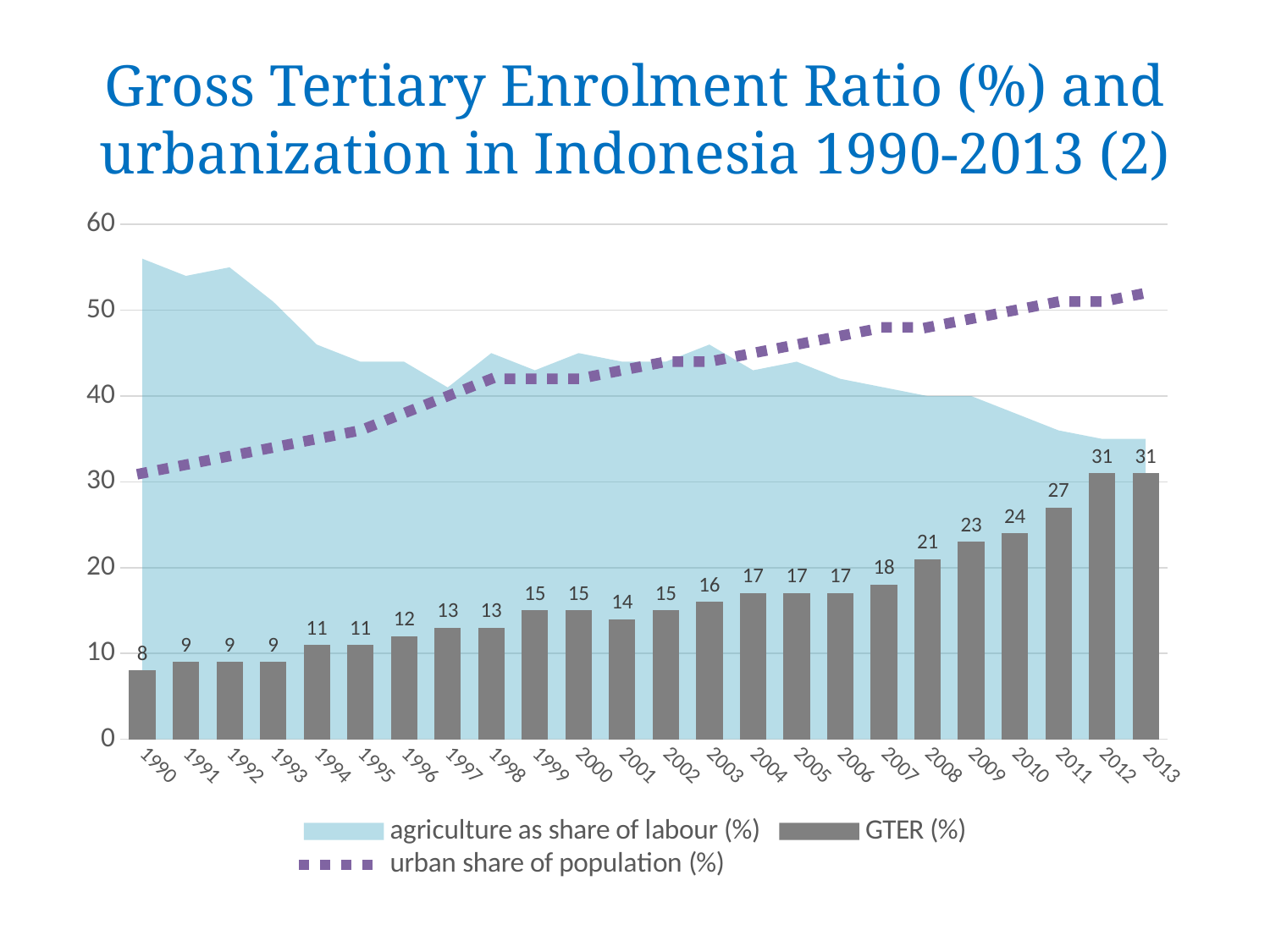
Is the urban share of population (%) value for 1990 greater or less than 40? less Is the agriculture as share of labour (%) value for 1990 greater or less than 50? greater Does the urban share of population (%) series rise or fall from 1990 to 2013? rise How many years are shown on the x axis? 24 What is the GTER (%) value for 2008? 21 Which series is drawn as a dotted line? urban share of population (%) Does the agriculture as share of labour (%) series rise or fall from 1990 to 2013? fall What is the difference between the GTER (%) values for 2013 and 1990? 23 Which year has the lowest GTER (%) value? 1990 Which year has the larger GTER (%) value, 2000 or 2001? 2000 How many series does the legend list? 3 What is the GTER (%) value for 1990? 8